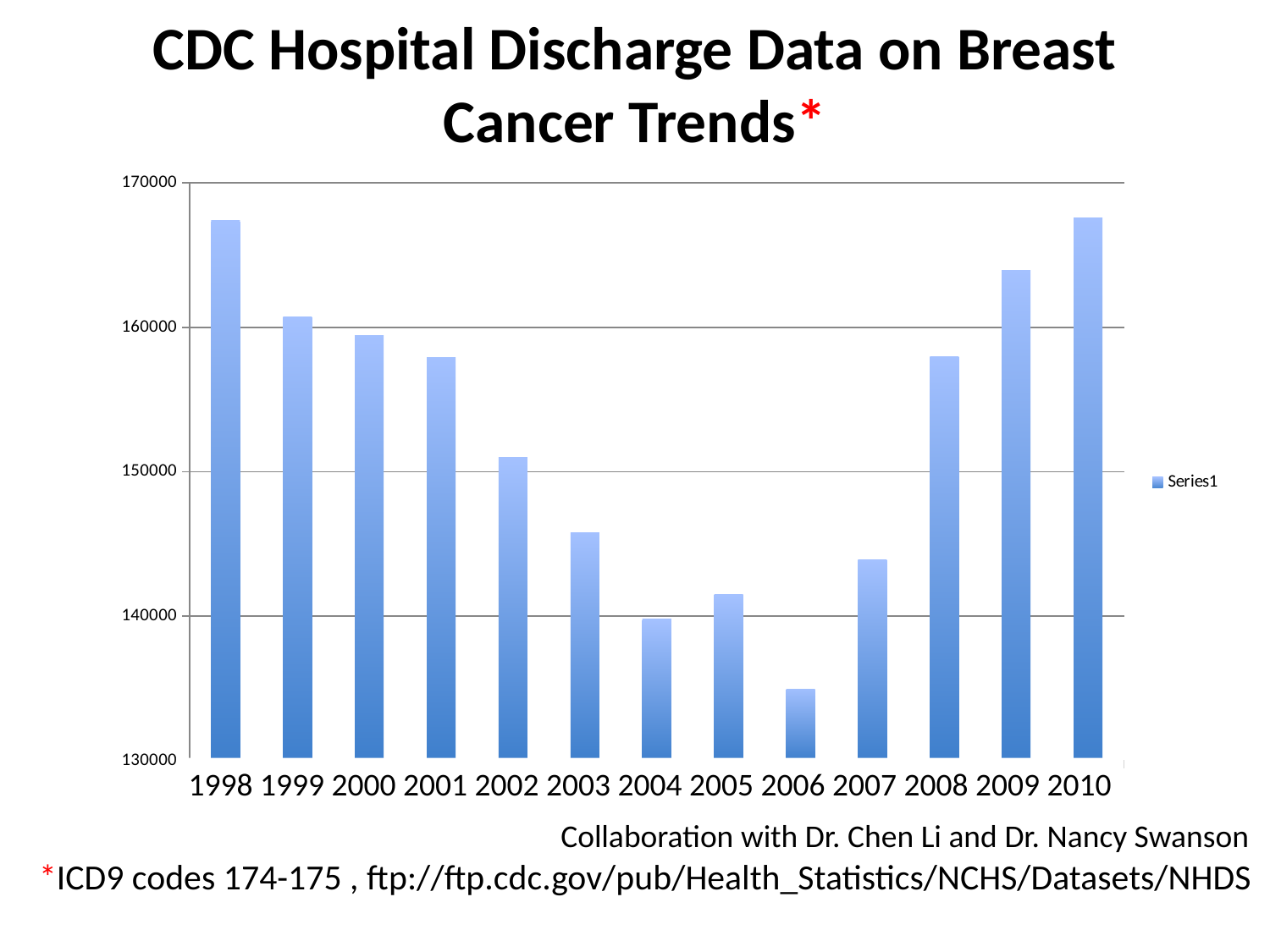
Which is larger, the value for 2008 or the value for 2009? 2009 Is the value for 2006 greater or less than 140000? less How many series does the legend list? 1 What kind of chart is shown on the slide? bar chart Is the value for 2007 greater or less than 150000? less Is the value for 2005 greater or less than 140000? greater Do the values rise or fall from 1998 to 2006? fall How many years are shown on the x axis of the chart? 13 What is the legend entry shown on the chart? Series1 Which year has the lowest value in the chart? 2006